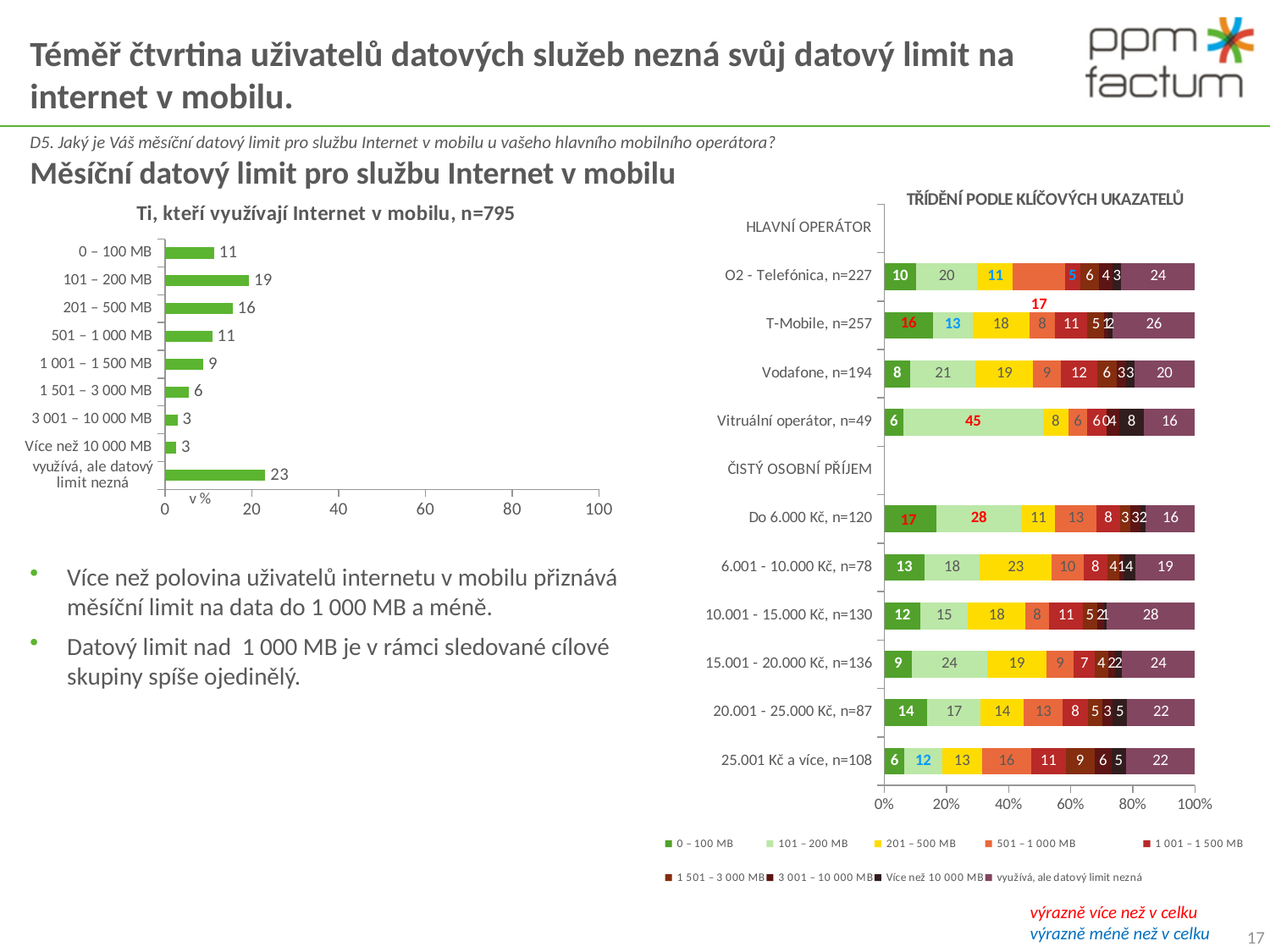
In the right chart 'TŘÍDĚNÍ PODLE KLÍČOVÝCH UKAZATELŮ', what is the value of the 'využívá, ale datový limit nezná' segment for 'T-Mobile, n=257'? 26 In the left chart 'Ti, kteří využívají Internet v mobilu, n=795', what is the value for 'využívá, ale datový limit nezná'? 23 In the left chart 'Ti, kteří využívají Internet v mobilu, n=795', what is the difference between the values for '101 – 200 MB' and '201 – 500 MB'? 3 In the right chart 'TŘÍDĚNÍ PODLE KLÍČOVÝCH UKAZATELŮ', how many series does the legend list? 9 In the right chart 'TŘÍDĚNÍ PODLE KLÍČOVÝCH UKAZATELŮ', what is the value of the '101 – 200 MB' segment for 'Vitruální operátor, n=49'? 45 In the left chart 'Ti, kteří využívají Internet v mobilu, n=795', which category has the highest value? využívá, ale datový limit nezná In the left chart 'Ti, kteří využívají Internet v mobilu, n=795', is the value for '1 501 – 3 000 MB' greater or less than 20? less In the left chart 'Ti, kteří využívají Internet v mobilu, n=795', how many categories are shown? 9 In the right chart 'TŘÍDĚNÍ PODLE KLÍČOVÝCH UKAZATELŮ', what is the value of the '0 – 100 MB' segment for 'Do 6.000 Kč, n=120'? 17 In the left chart 'Ti, kteří využívají Internet v mobilu, n=795', which is larger: the value for '0 – 100 MB' or the value for '1 001 – 1 500 MB'? 0 – 100 MB What kind of chart is the left chart 'Ti, kteří využívají Internet v mobilu, n=795'? bar chart In the left chart 'Ti, kteří využívají Internet v mobilu, n=795', what is the value for '101 – 200 MB'? 19